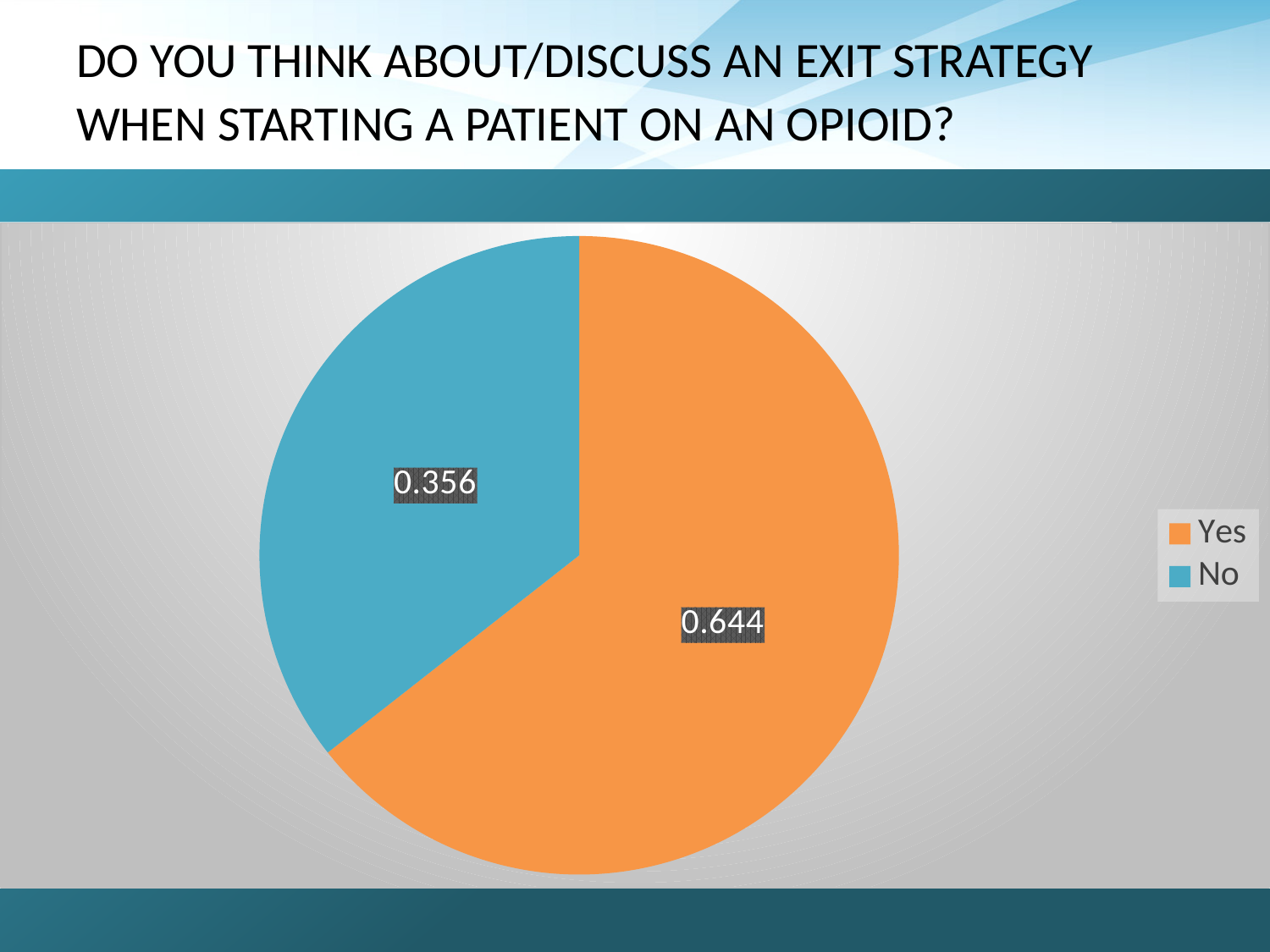
Which category has the largest slice of the pie? Yes What kind of chart is shown on the slide? Pie chart What is the value shown for the No slice? 0.356 Which category has the smallest slice of the pie? No How many slices does the pie chart have? 2 What colour is the Yes slice? Orange What is the value shown for the Yes slice? 0.644 How many entries does the legend list? 2 What colour is the No slice? Blue What is the difference between the Yes value and the No value? 0.288 Which is larger, the Yes slice or the No slice? Yes